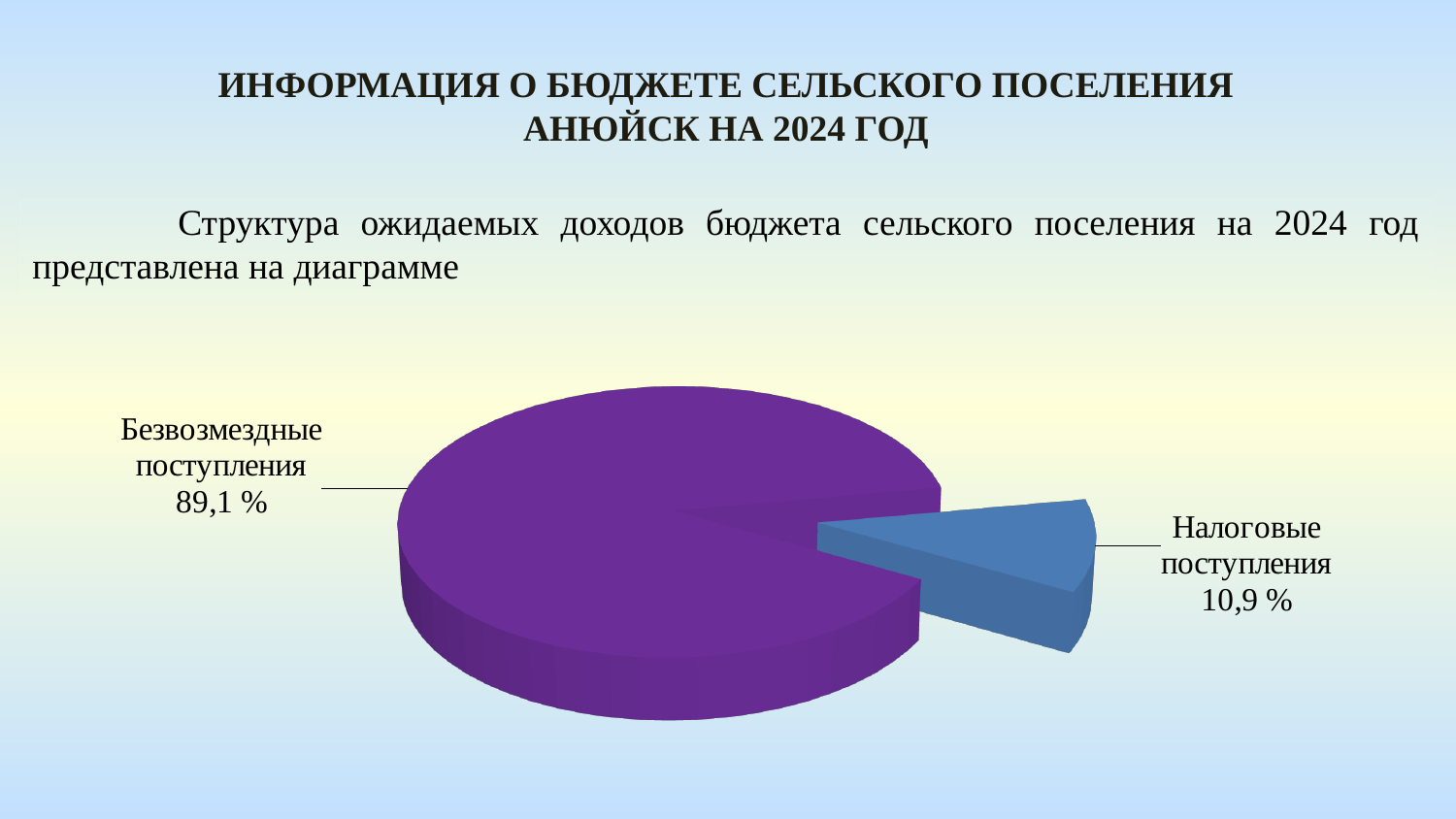
Which slice of the pie chart is the largest? Безвозмездные поступления What is the difference in percentage points between Безвозмездные поступления and Налоговые поступления? 78,2 Which slice of the pie chart is the smallest? Налоговые поступления Which is larger: Безвозмездные поступления or Налоговые поступления? Безвозмездные поступления What colour is the slice for Безвозмездные поступления? Purple What kind of chart is shown on the slide? Pie chart What is the total of the two slice percentages shown on the pie chart? 100 % How many slices does the pie chart have? 2 What share of the pie is labelled Налоговые поступления? 10,9 % What share of the pie is labelled Безвозмездные поступления? 89,1 % What colour is the slice for Налоговые поступления? Blue